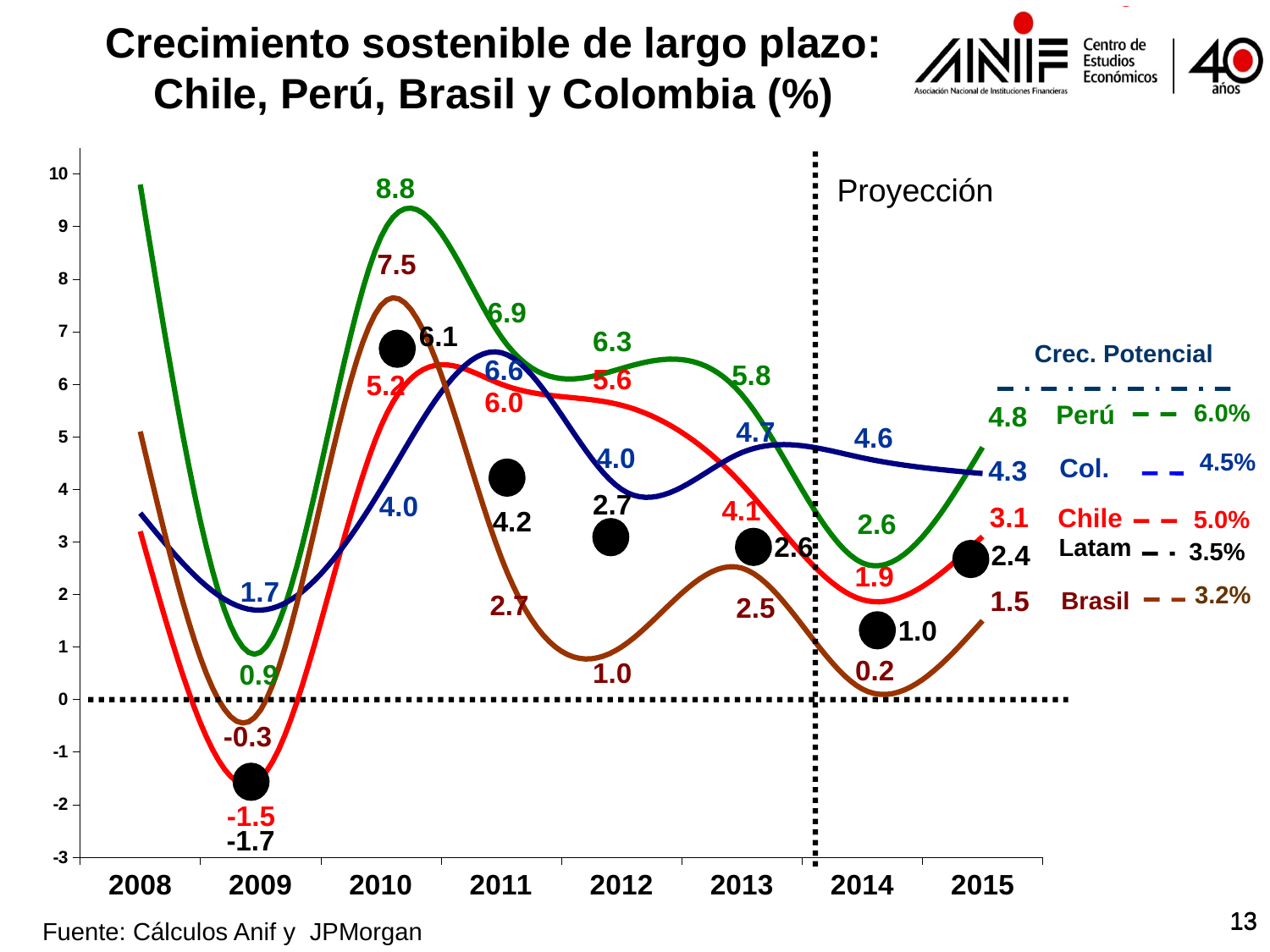
What is the Latam value in 2009? -1.7 What is the value for Col. (Colombia) in 2011? 6.6 In which year does Perú reach its highest value? 2008 How many years are shown on the x axis? 8 What is the difference between the Perú and Brasil values in 2010? 1.3 How many series does the legend list? 5 What is the value for Brasil in 2014? 0.2 In 2013, which is larger: the value for Col. or the value for Chile? Col. What kind of chart is shown on the slide? Line chart In which year does Chile have its lowest value? 2009 What is the 'Crec. Potencial' value shown for Perú? 6.0% What is the value for Perú in 2010? 8.8